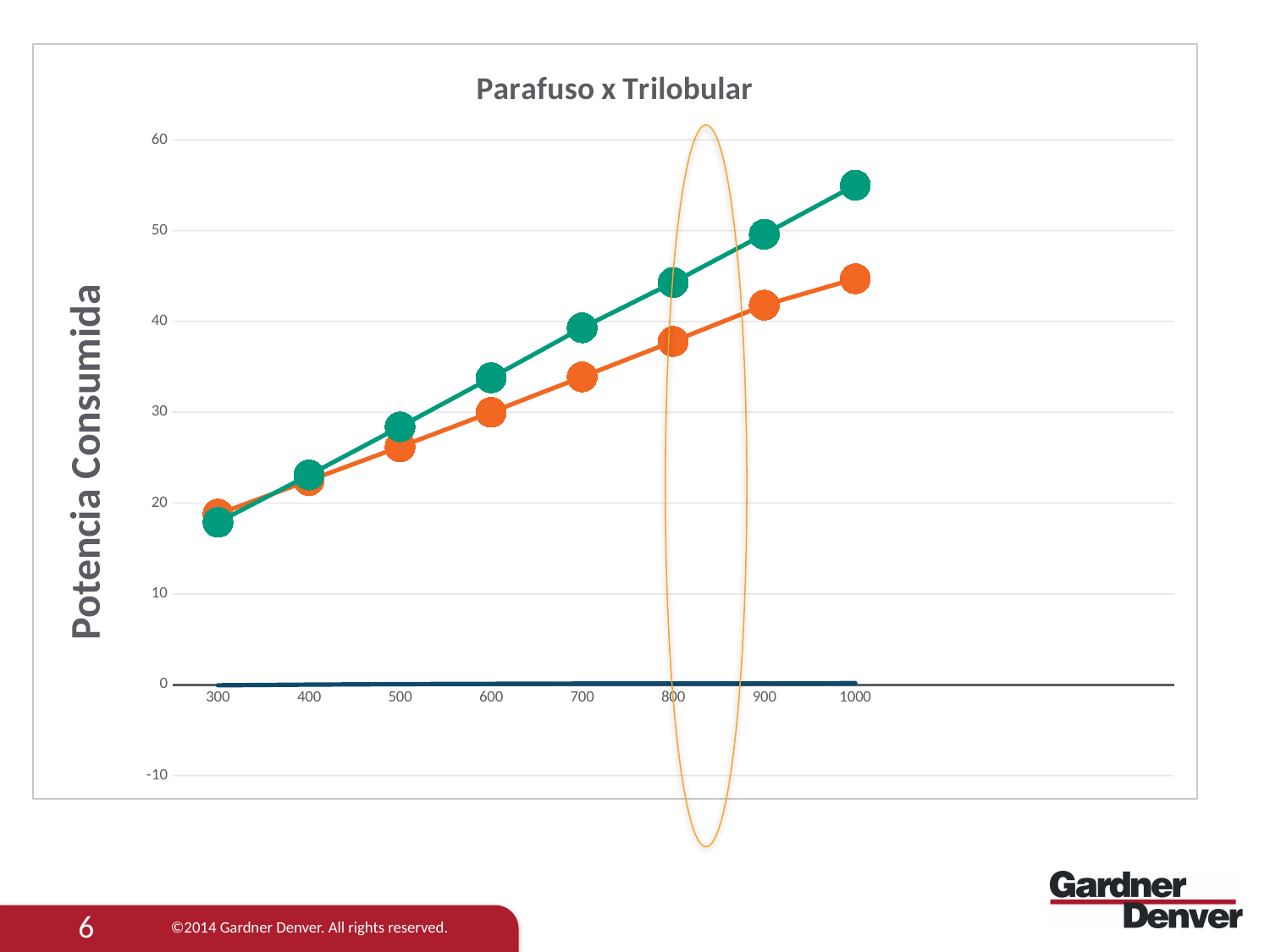
What is the title of the chart? Parafuso x Trilobular How many x-axis categories are plotted on the chart? 8 What kind of chart is shown on the slide? line chart Is the value of the green line at 1000 greater or less than 50? greater At which x-axis value does the green line reach its highest point? 1000 At x = 1000, which line has the higher value, the green line or the orange line? the green line What is the label on the vertical axis of the chart? Potencia Consumida Do the values of the green line rise or fall as the x axis goes from 300 to 1000? rise Do the values of the orange line rise or fall as the x axis goes from 300 to 1000? rise Is the value of the orange line at 800 greater or less than 40? less Is the value of the orange line at 1000 greater or less than 50? less